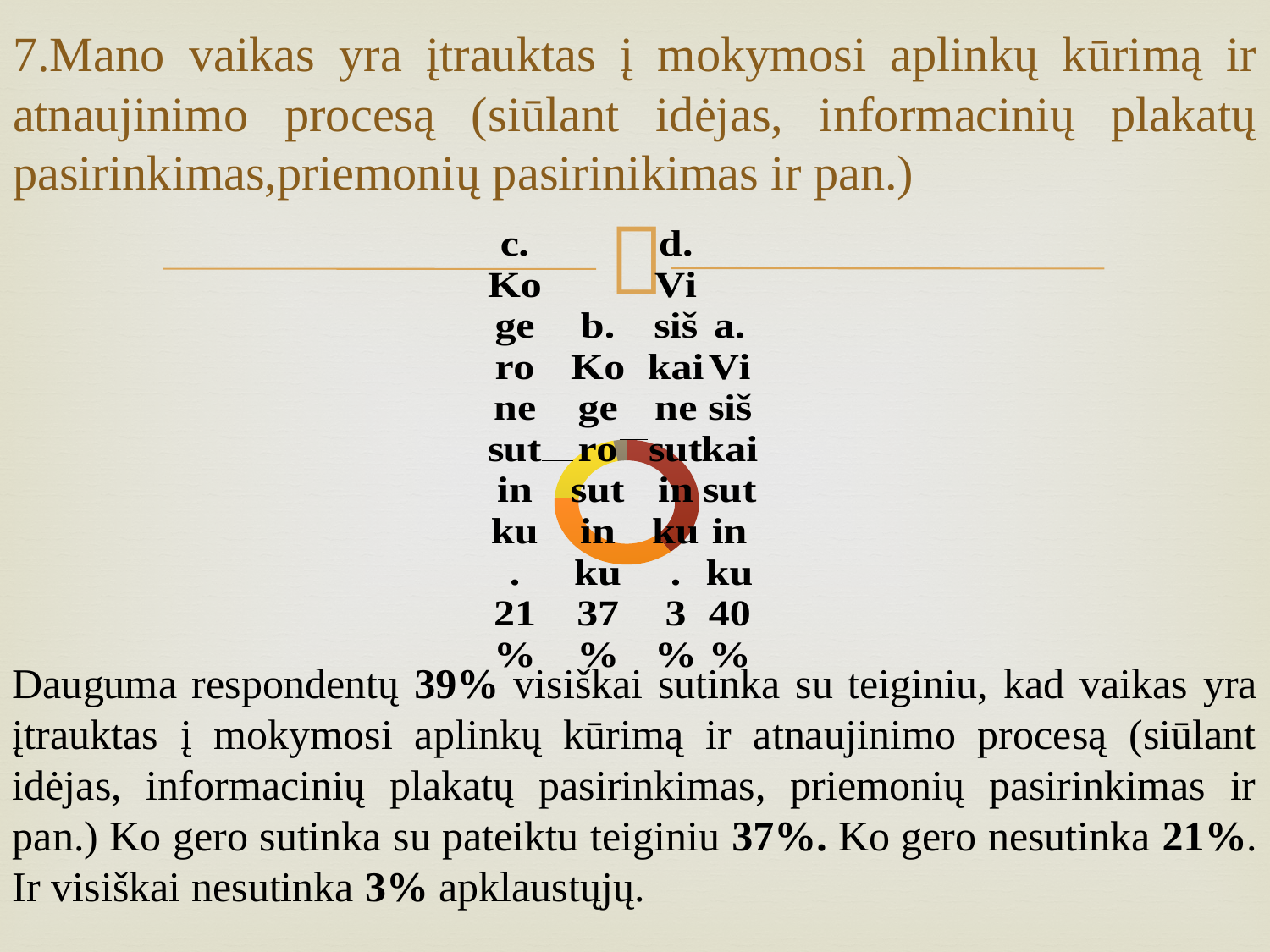
Which category has the smallest share in the chart? d. Visiškai nesutinku What percentage is shown for "a. Visiškai sutinku" in the chart? 40% What is the difference between the shares of "a. Visiškai sutinku" and "b. Ko gero sutinku"? 3% Which category has the largest share in the chart? a. Visiškai sutinku How many categories does the doughnut chart show? 4 What percentage is shown for "c. Ko gero nesutinku" in the chart? 21% Which is larger in the chart: "b. Ko gero sutinku" or "c. Ko gero nesutinku"? b. Ko gero sutinku What kind of chart is shown on the slide? doughnut chart What percentage is shown for "d. Visiškai nesutinku" in the chart? 3% What is the difference between the shares of "b. Ko gero sutinku" and "c. Ko gero nesutinku"? 16% What percentage is shown for "b. Ko gero sutinku" in the chart? 37% Which is larger in the chart: "c. Ko gero nesutinku" or "d. Visiškai nesutinku"? c. Ko gero nesutinku